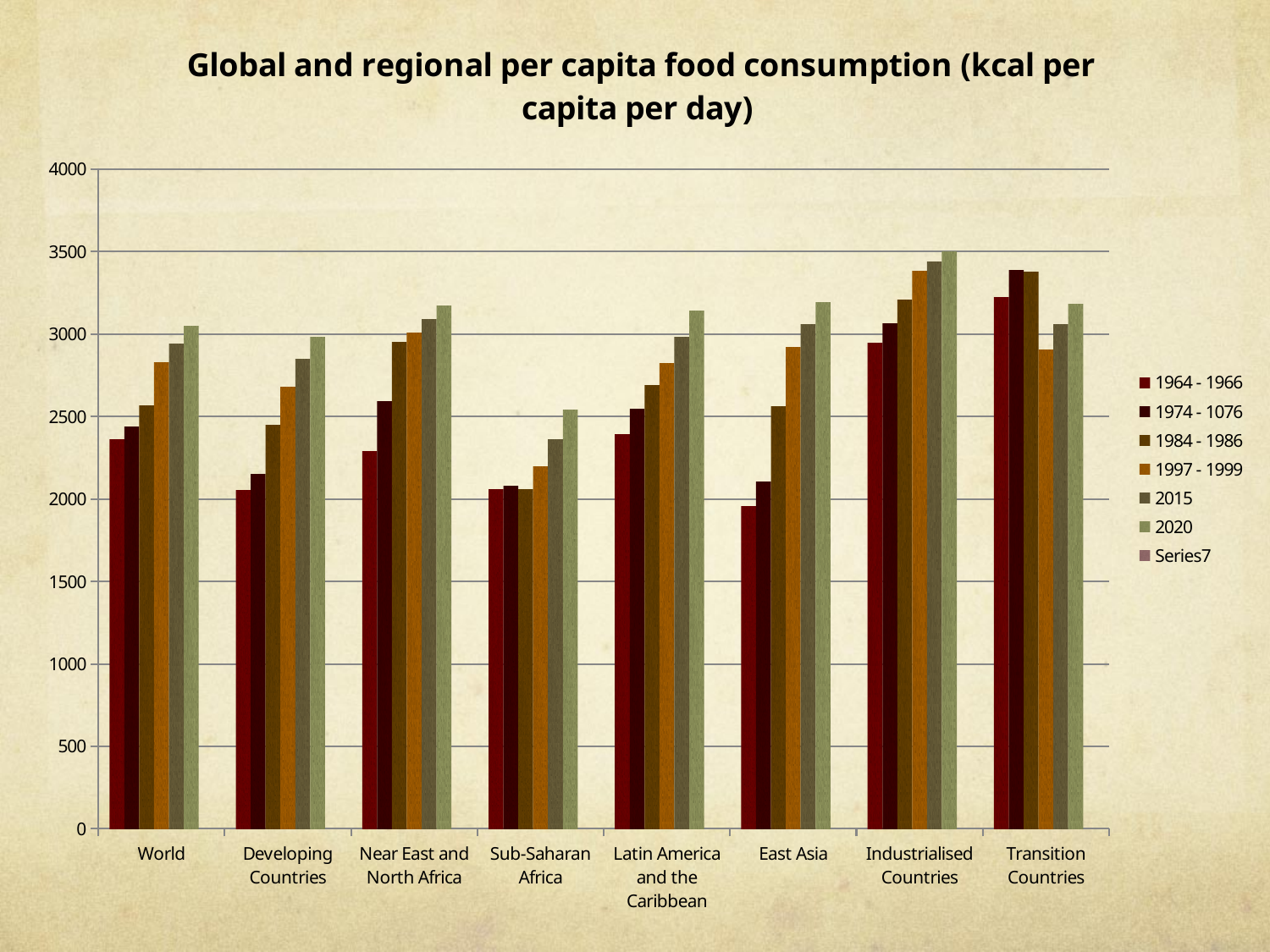
Which category has the lowest value for the 1964 - 1966 series? East Asia Which is larger, the 1964 - 1966 value for Transition Countries or the 1964 - 1966 value for World? Transition Countries Which category has the highest value for the 2020 series? Industrialised Countries Is the 2020 value for Sub-Saharan Africa greater or less than 3000? less Is the 1997 - 1999 value for Industrialised Countries greater or less than 3000? greater How many regions/categories are shown along the x axis? 8 Do the values for East Asia rise or fall from the 1964 - 1966 series to the 2020 series? rise For Transition Countries, which series has the lowest value? 1997 - 1999 Is the 1964 - 1966 value for Developing Countries greater or less than 2500? less Which is larger, the 1997 - 1999 value for Industrialised Countries or the 1997 - 1999 value for Transition Countries? Industrialised Countries What kind of chart is shown on the slide? bar chart How many series does the legend list? 7